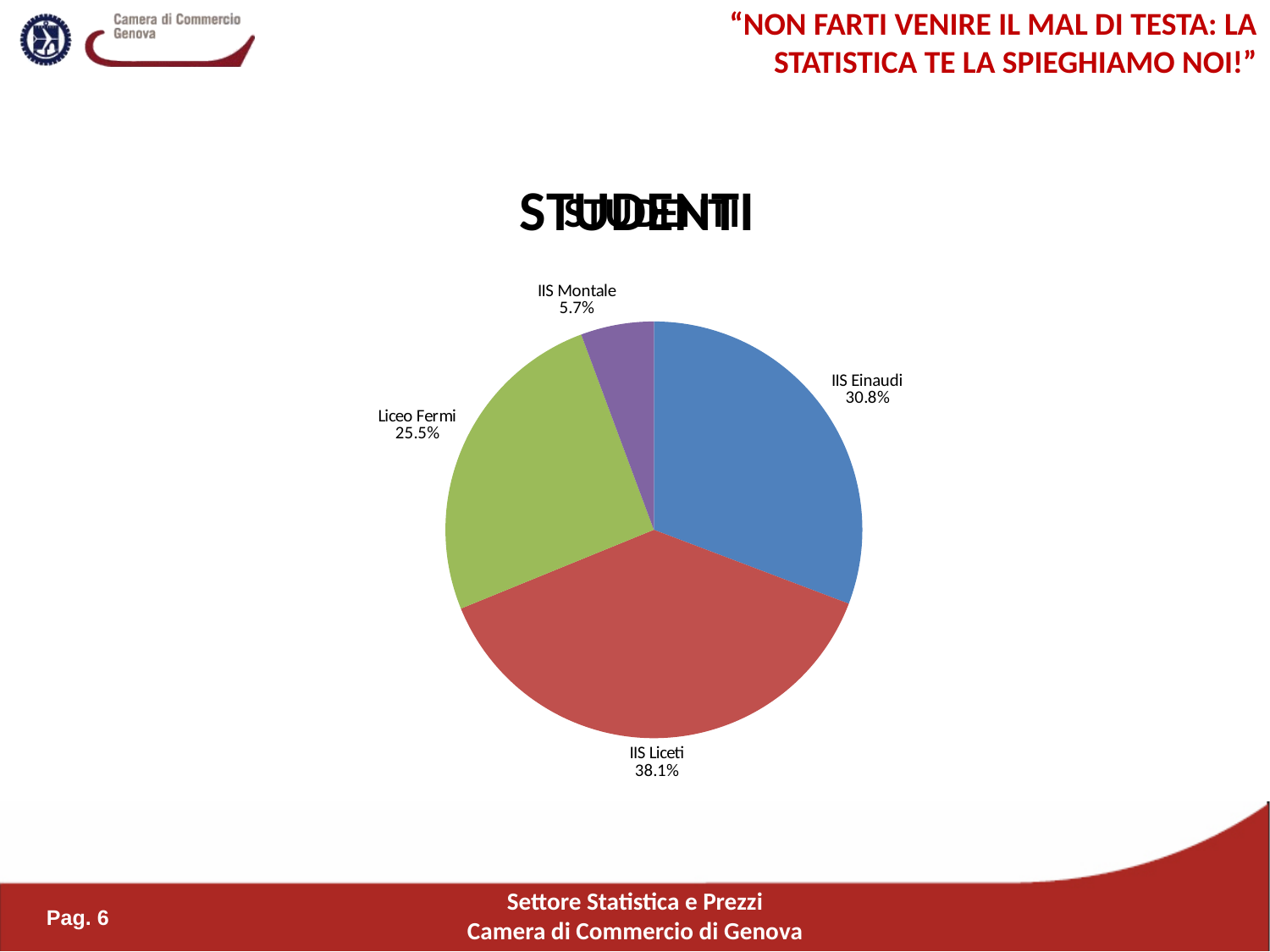
What share of the pie does Liceo Fermi hold? 25.5% What kind of chart is shown on the slide? Pie chart What share of the pie does IIS Liceti hold? 38.1% Which school has the largest slice of the pie? IIS Liceti Which is larger, the share for Liceo Fermi or the share for IIS Einaudi? IIS Einaudi How many slices does the pie chart have? 4 What is the difference in percentage points between IIS Liceti and IIS Einaudi? 7.3 What share of the pie does IIS Montale hold? 5.7% What is the combined share of IIS Liceti and Liceo Fermi? 63.6% What colour is the slice for IIS Montale? Purple Which school has the smallest slice of the pie? IIS Montale What share of the pie does IIS Einaudi hold? 30.8%